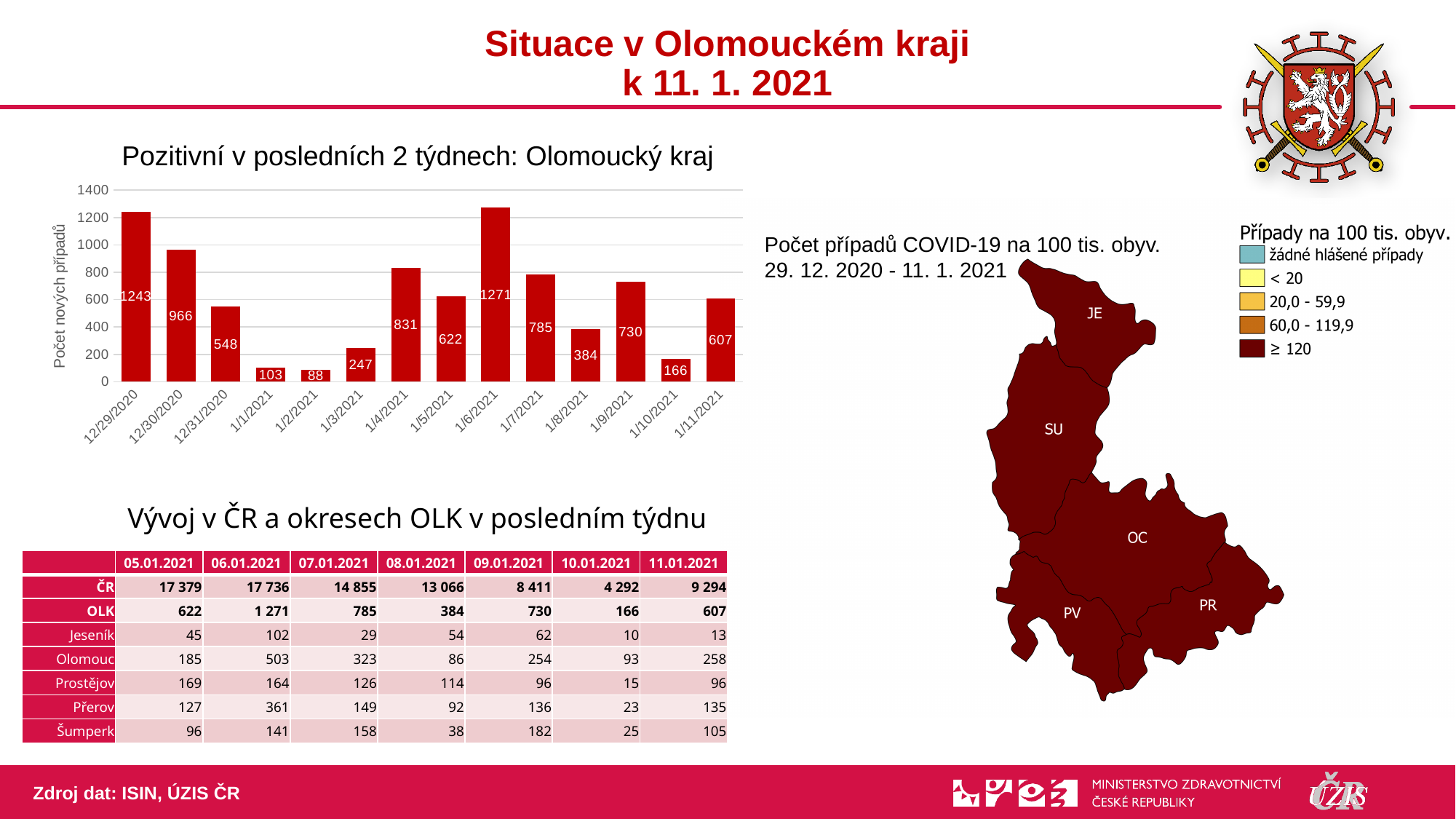
In the bar chart, what is the difference between the values for 12/30/2020 and 12/31/2020? 418 In the bar chart, what is the value for 12/29/2020? 1243 In the bar chart, which date has the highest number of new cases? 1/6/2021 In the bar chart, what is the value for 1/11/2021? 607 In the bar chart, what is the value for 1/8/2021? 384 In the bar chart, what is the difference between the values for 1/6/2021 and 12/29/2020? 28 What is the label of the vertical axis of the bar chart? Počet nových případů What type of chart is shown under the title 'Pozitivní v posledních 2 týdnech: Olomoucký kraj'? bar chart In the bar chart, which date has the lowest number of new cases? 1/2/2021 In the bar chart, is the value for 1/9/2021 greater or less than 600? greater In the bar chart, which date has a larger value, 1/4/2021 or 1/7/2021? 1/4/2021 How many dates (bars) are shown in the bar chart? 14